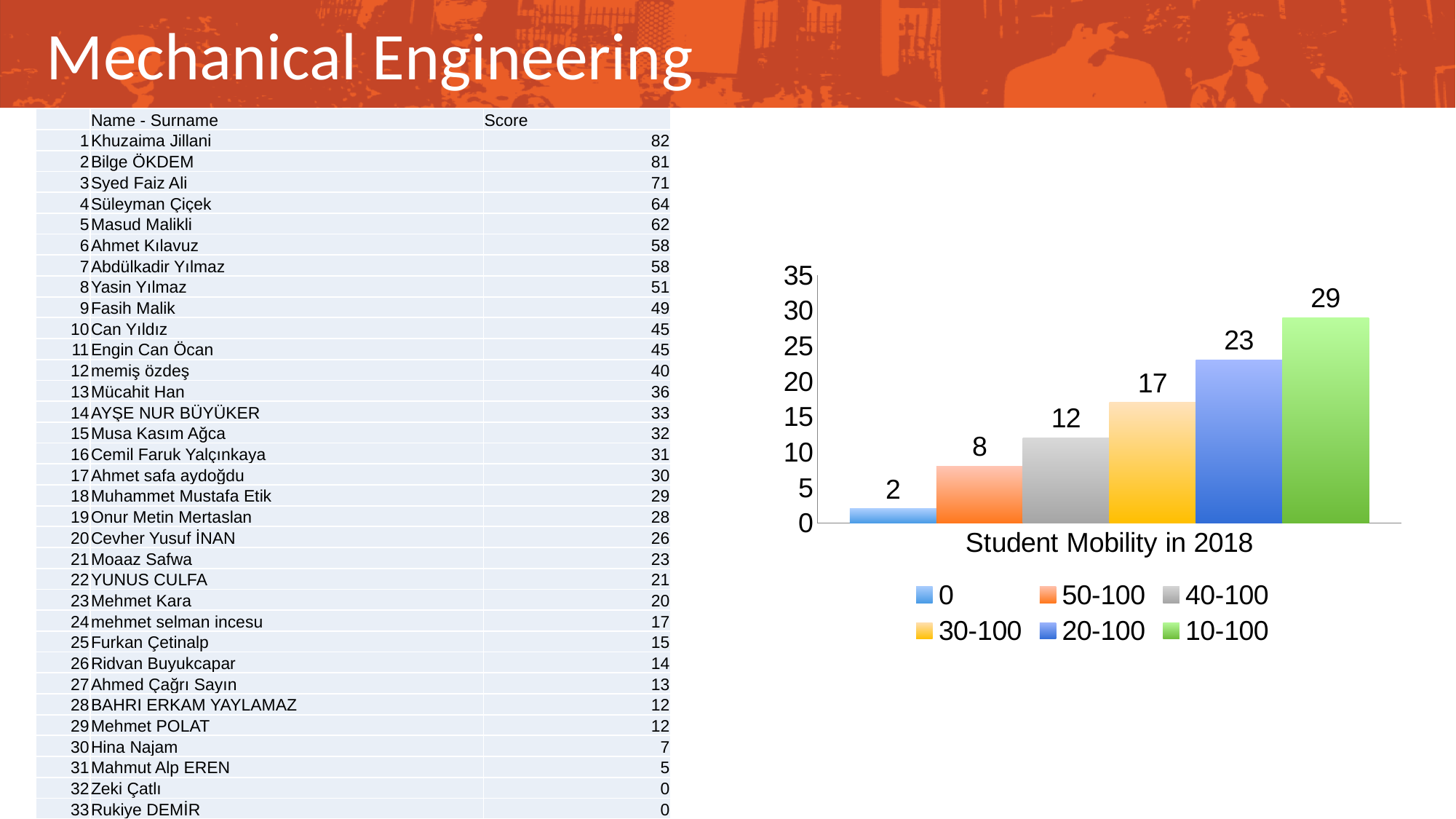
What colour is the bar for the "50-100" series? orange Which series has the lowest value in the chart? 0 Which series has the highest value in the chart? 10-100 What type of chart is shown on the slide? bar chart What is the value of the "10-100" series in the chart? 29 What is the difference between the values of the "20-100" and "40-100" series? 11 What is the category label shown on the x axis of the chart? Student Mobility in 2018 Which is larger, the value for "30-100" or the value for "40-100"? 30-100 What is the value of the "50-100" series in the chart? 8 How many series does the chart legend list? 6 What is the value of the "30-100" series in the chart? 17 What is the value of the "0" series in the chart? 2